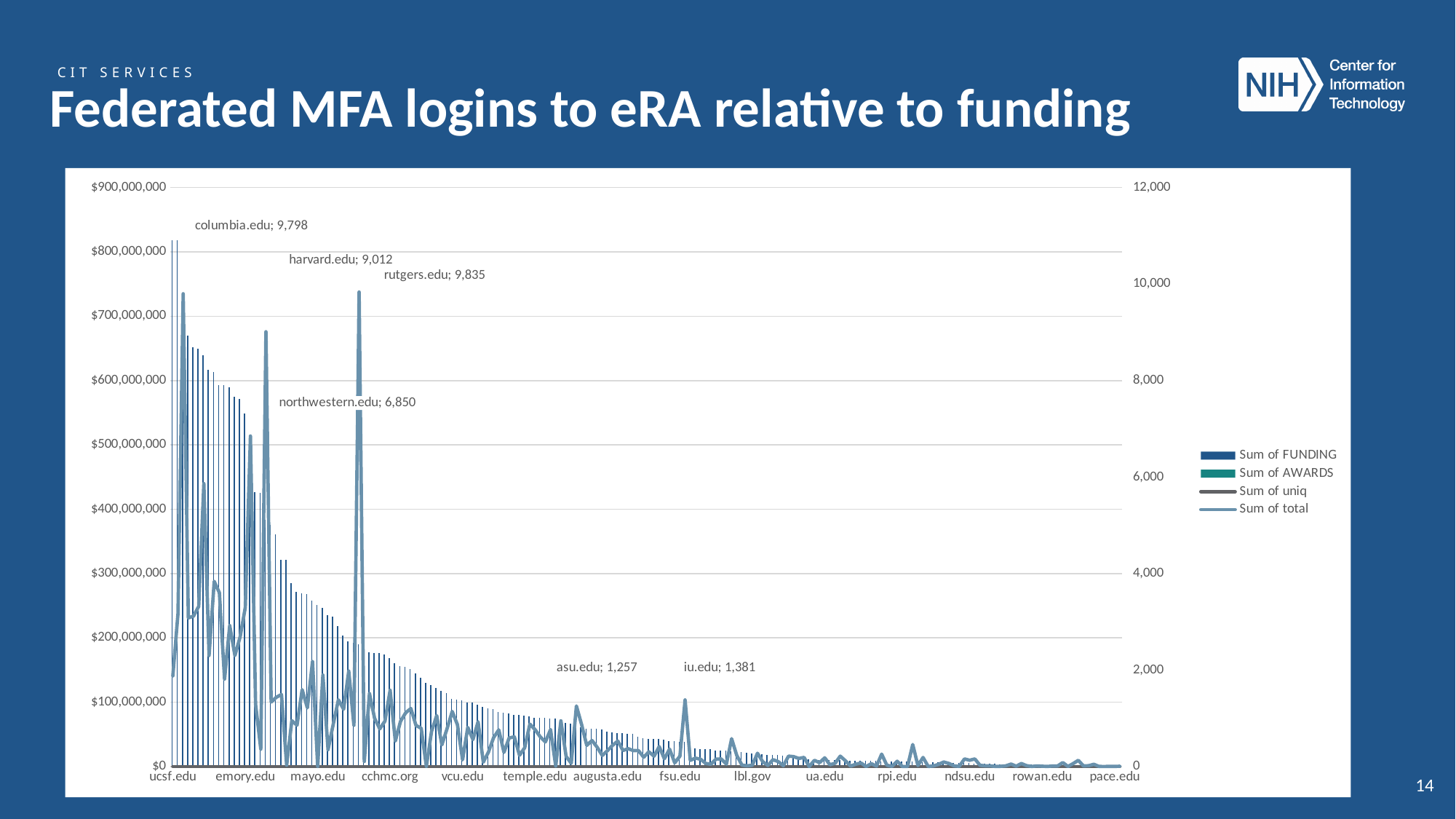
How many series does the legend list? 4 What value is shown in the data label for rutgers.edu? 9,835 Which has the larger labeled value, columbia.edu or rutgers.edu? rutgers.edu Among the institutions with data labels, which has the highest labeled value? rutgers.edu What value is shown in the data label for columbia.edu? 9,798 What value is shown in the data label for iu.edu? 1,381 What is the difference between the labeled values for iu.edu and asu.edu? 124 Is the Sum of FUNDING bar for ucsf.edu greater or less than $700,000,000? greater Do the Sum of FUNDING bars generally rise or fall from left to right along the x axis? fall What is the difference between the labeled values for harvard.edu and northwestern.edu? 2,162 What value is shown in the data label for harvard.edu? 9,012 What value is shown in the data label for northwestern.edu? 6,850